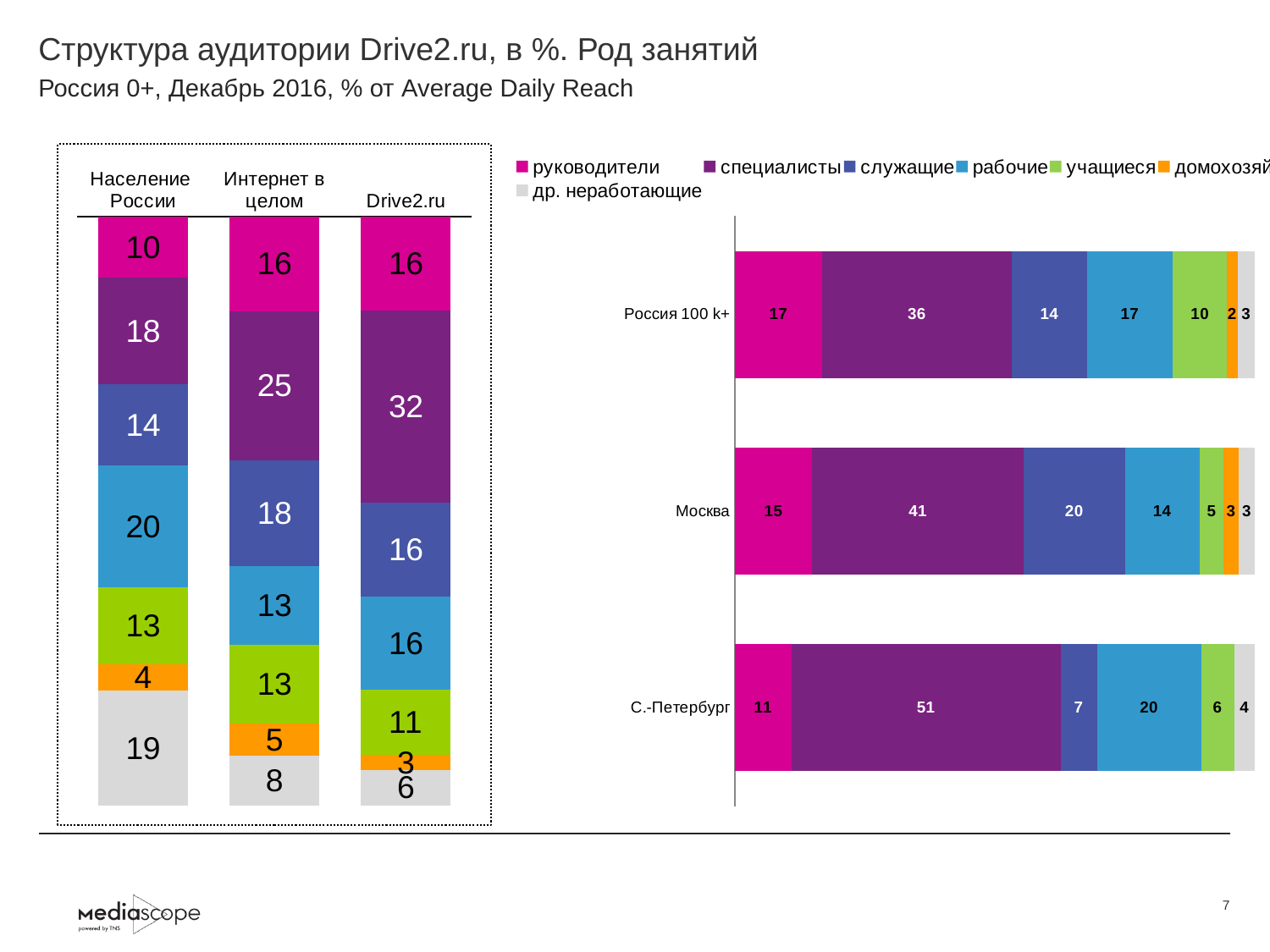
In the left-hand chart, what is the value of the grey (др. неработающие) segment for Население России? 19 In the right-hand chart, what is the value for специалисты in Москва? 41 In the right-hand chart, what is the difference between the специалисты values for С.-Петербург and Россия 100 k+? 34 In the left-hand chart, what is the total of the stacked bar for Drive2.ru? 100 In the left-hand chart, what is the value of the purple (специалисты) segment for Drive2.ru? 32 In the left-hand chart, which is larger: the pink (руководители) segment for Население России or for Drive2.ru? Drive2.ru What type of chart is the right-hand chart? Stacked bar chart How many series does the legend of the right-hand chart list? 7 In the right-hand chart, which region has the highest value for специалисты? С.-Петербург In the right-hand chart, which region has the lowest value for руководители? С.-Петербург In the right-hand chart, what is the value for рабочие in С.-Петербург? 20 In the left-hand chart, how many categories (bars) are shown? 3